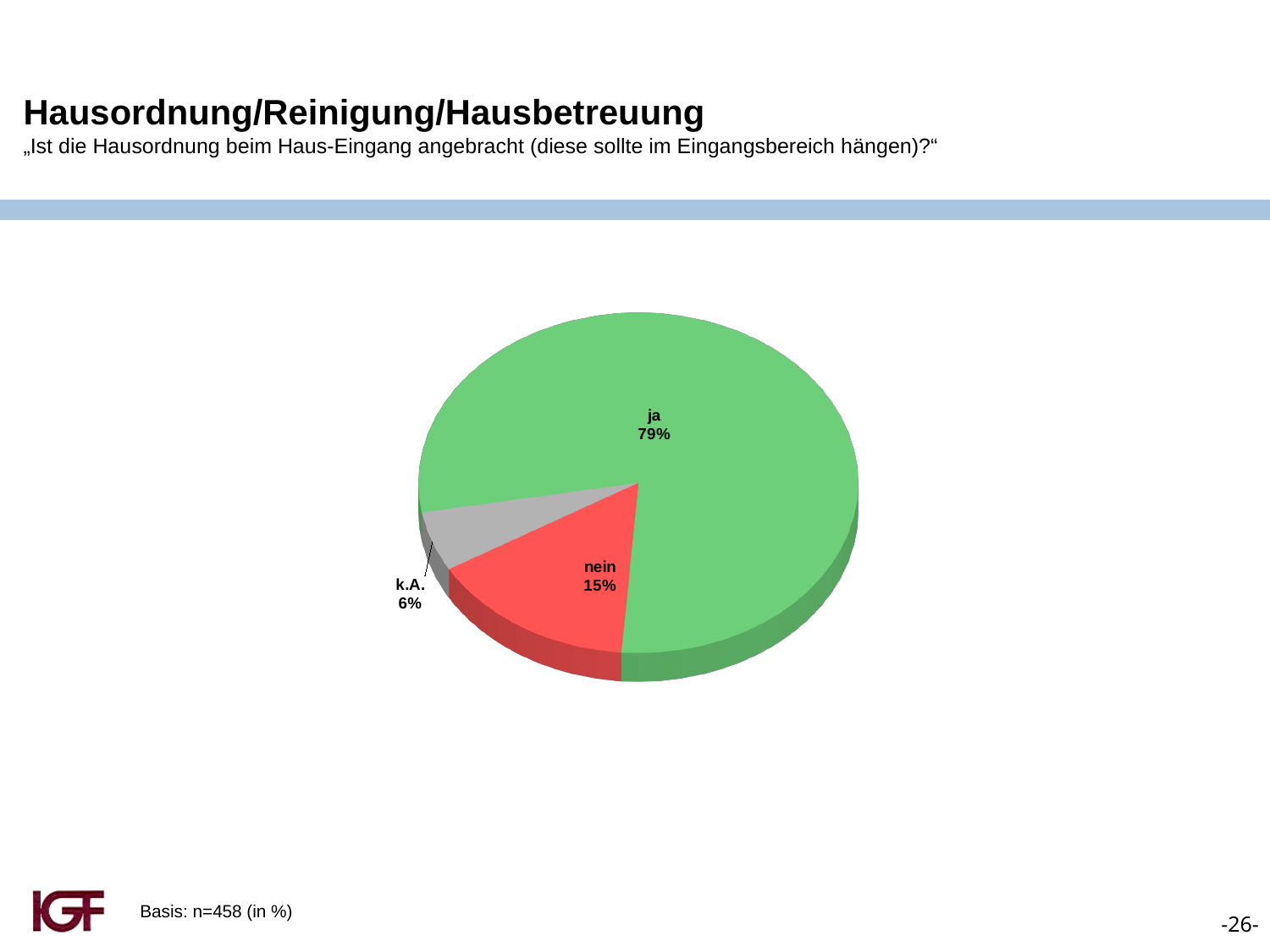
Which is larger, the share for "nein" or the share for "k.A."? nein Which category has the largest slice of the pie? ja What share of the pie does "ja" have? 79% What share of the pie does "nein" have? 15% What is the difference in percentage points between "nein" and "k.A."? 9 What colour is the "ja" slice of the pie? green Which category has the smallest slice of the pie? k.A. What share of the pie does "k.A." have? 6% What is the difference in percentage points between "ja" and "nein"? 64 How many slices does the pie chart have? 3 What kind of chart is shown on the slide? pie chart What is the sample size (Basis) stated on the slide? n=458